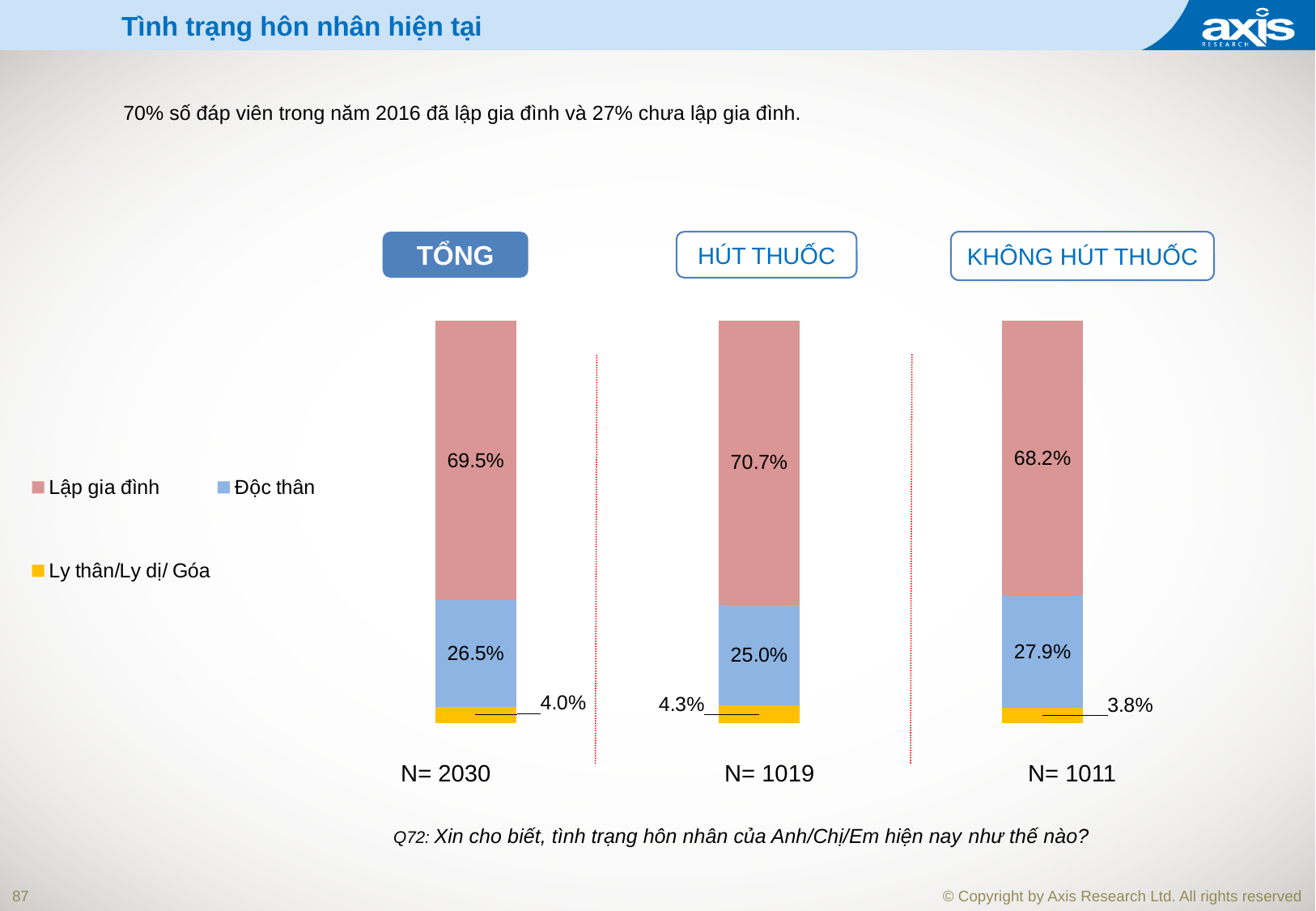
How many series does the legend list? 3 What kind of chart is shown on the slide? Stacked bar chart Which legend entry is shown in yellow? Ly thân/Ly dị/ Góa What is the value of Độc thân for the HÚT THUỐC group? 25.0% What is the difference between the Độc thân values for KHÔNG HÚT THUỐC and HÚT THUỐC? 2.9% Which is larger: the Ly thân/Ly dị/ Góa value for TỔNG or for HÚT THUỐC? HÚT THUỐC Which group has the highest value for Lập gia đình? HÚT THUỐC Which group has the lowest value for Độc thân? HÚT THUỐC How many bars (groups) are plotted in the chart? 3 What is the value of Lập gia đình for the TỔNG group? 69.5% What is the value of Ly thân/Ly dị/ Góa for the KHÔNG HÚT THUỐC group? 3.8% What is the sample size (N) shown for the KHÔNG HÚT THUỐC group? N= 1011